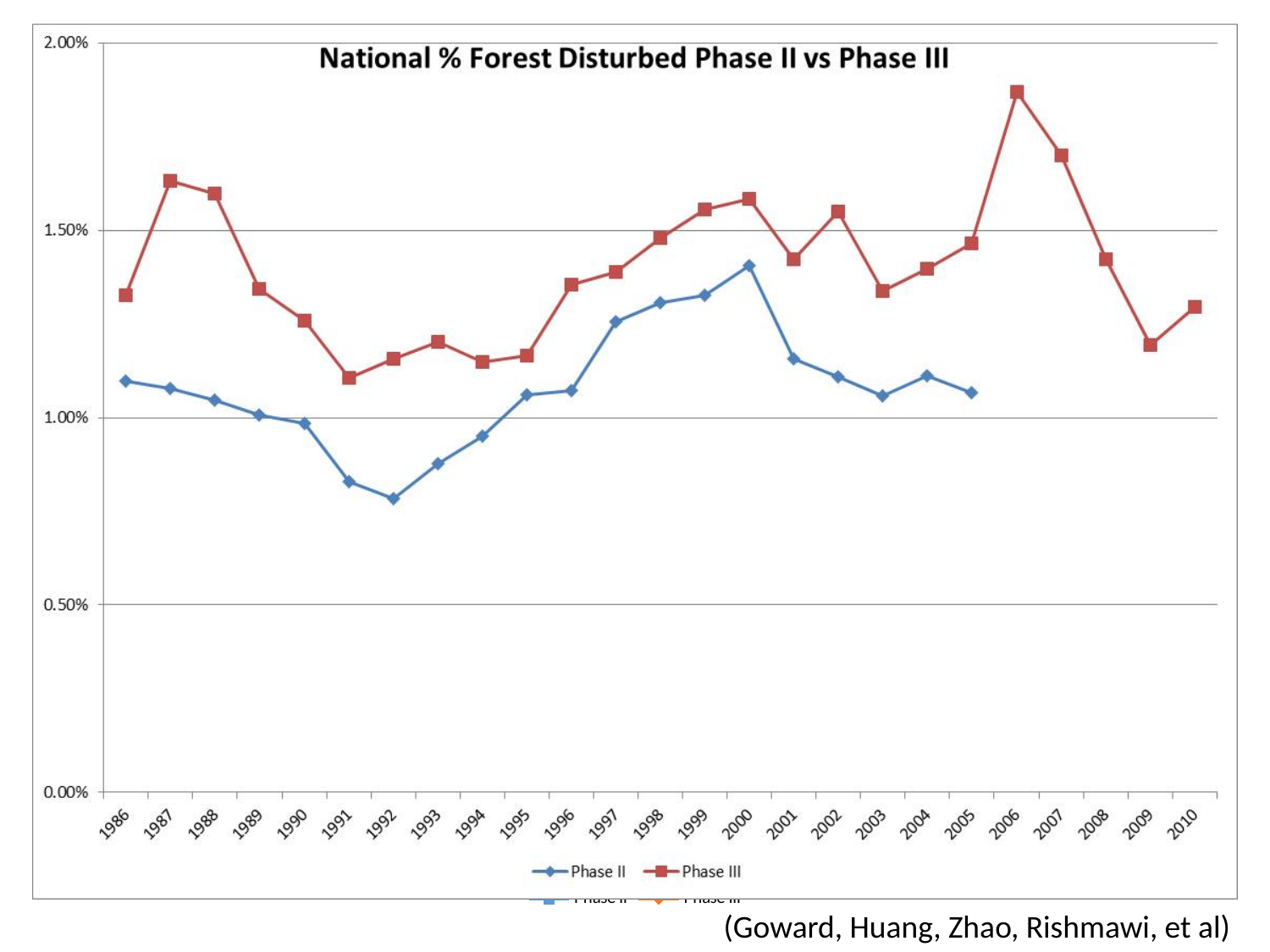
In which year does the Phase II series reach its highest value? 2000 Which series has the higher value in 1987, Phase II or Phase III? Phase III Does the Phase III series rise or fall from 2006 to 2009? Fall What kind of chart is shown on the slide? Line chart In which year does the Phase III series reach its highest value? 2006 What is the title of the chart? National % Forest Disturbed Phase II vs Phase III How many series does the legend list? 2 In which year does the Phase II series reach its lowest value? 1992 Is the Phase III value for 2006 greater or less than 1.50%? greater Is the Phase II value for 1992 greater or less than 1.00%? less How many years are shown on the x axis? 25 What are the two series named in the legend? Phase II and Phase III